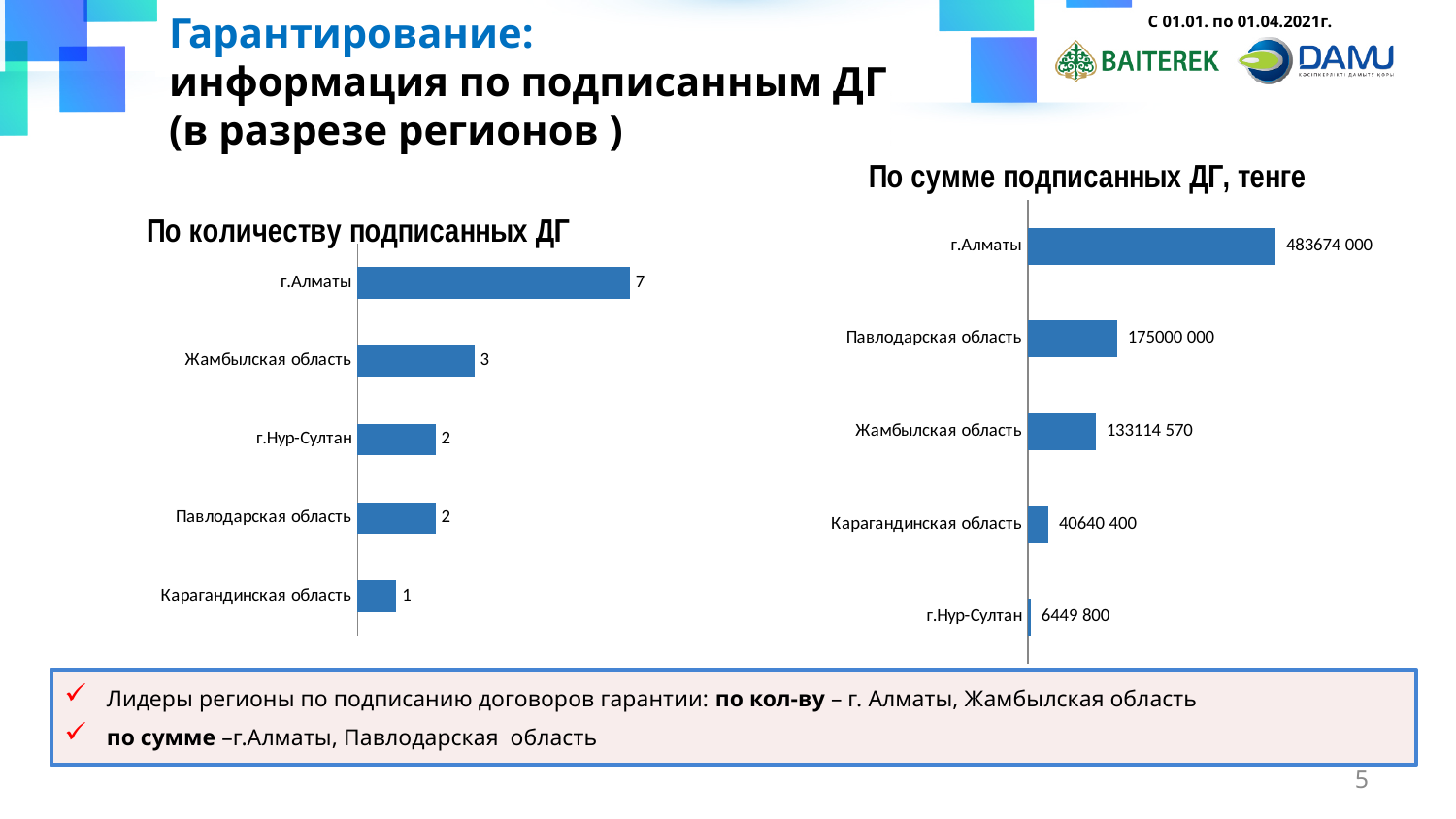
In the chart 'По сумме подписанных ДГ, тенге', what is the value for Карагандинская область? 40640 400 In the chart 'По сумме подписанных ДГ, тенге', what is the value for г.Нур-Султан? 6449 800 In the chart 'По сумме подписанных ДГ, тенге', which region has the highest value? г.Алматы In the chart 'По количеству подписанных ДГ', how many regions are shown? 5 In the chart 'По сумме подписанных ДГ, тенге', what is the value for Павлодарская область? 175000 000 In the chart 'По количеству подписанных ДГ', what is the value for Жамбылская область? 3 What is the title of the chart on the left side of the slide? По количеству подписанных ДГ What type of chart is 'По сумме подписанных ДГ, тенге'? Bar chart In the chart 'По сумме подписанных ДГ, тенге', which is larger: Жамбылская область or Карагандинская область? Жамбылская область In the chart 'По количеству подписанных ДГ', which region has the lowest value? Карагандинская область In the chart 'По количеству подписанных ДГ', what is the difference between г.Алматы and Жамбылская область? 4 In the chart 'По количеству подписанных ДГ', what is the value for г.Алматы? 7